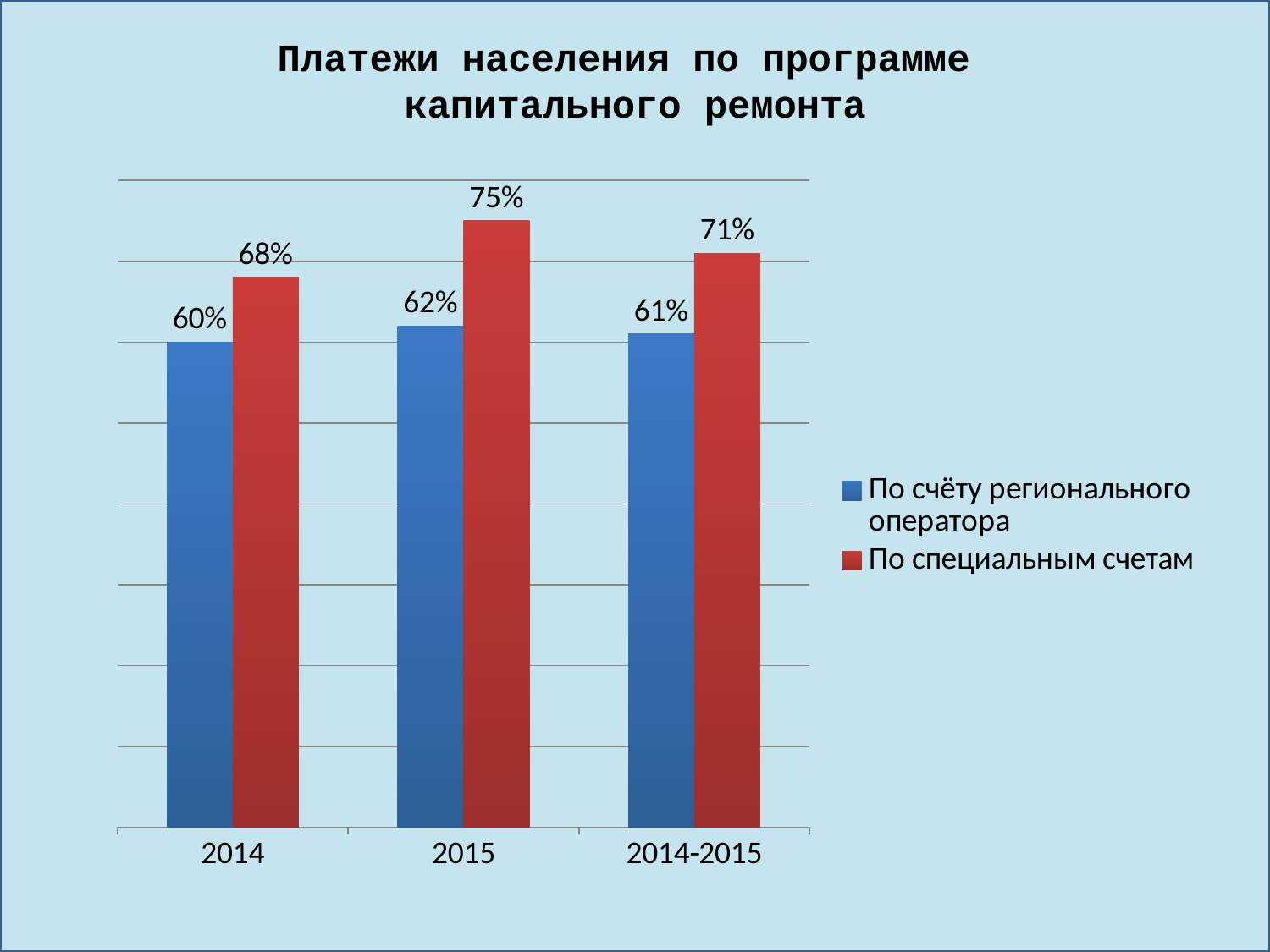
Which is larger in 2014: 'По счёту регионального оператора' or 'По специальным счетам'? По специальным счетам What is the difference between 'По специальным счетам' and 'По счёту регионального оператора' in 2015? 13% How many series does the legend list? 2 What is the value for 'По счёту регионального оператора' in 2014? 60% What kind of chart is shown on the slide? Bar chart How many categories are shown on the x axis? 3 In which category is the value for 'По счёту регионального оператора' lowest? 2014 In which category is the value for 'По специальным счетам' highest? 2015 What is the value for 'По специальным счетам' in 2015? 75% What is the value for 'По счёту регионального оператора' in 2015? 62% What is the title of the chart? Платежи населения по программе капитального ремонта What is the value for 'По специальным счетам' in 2014-2015? 71%